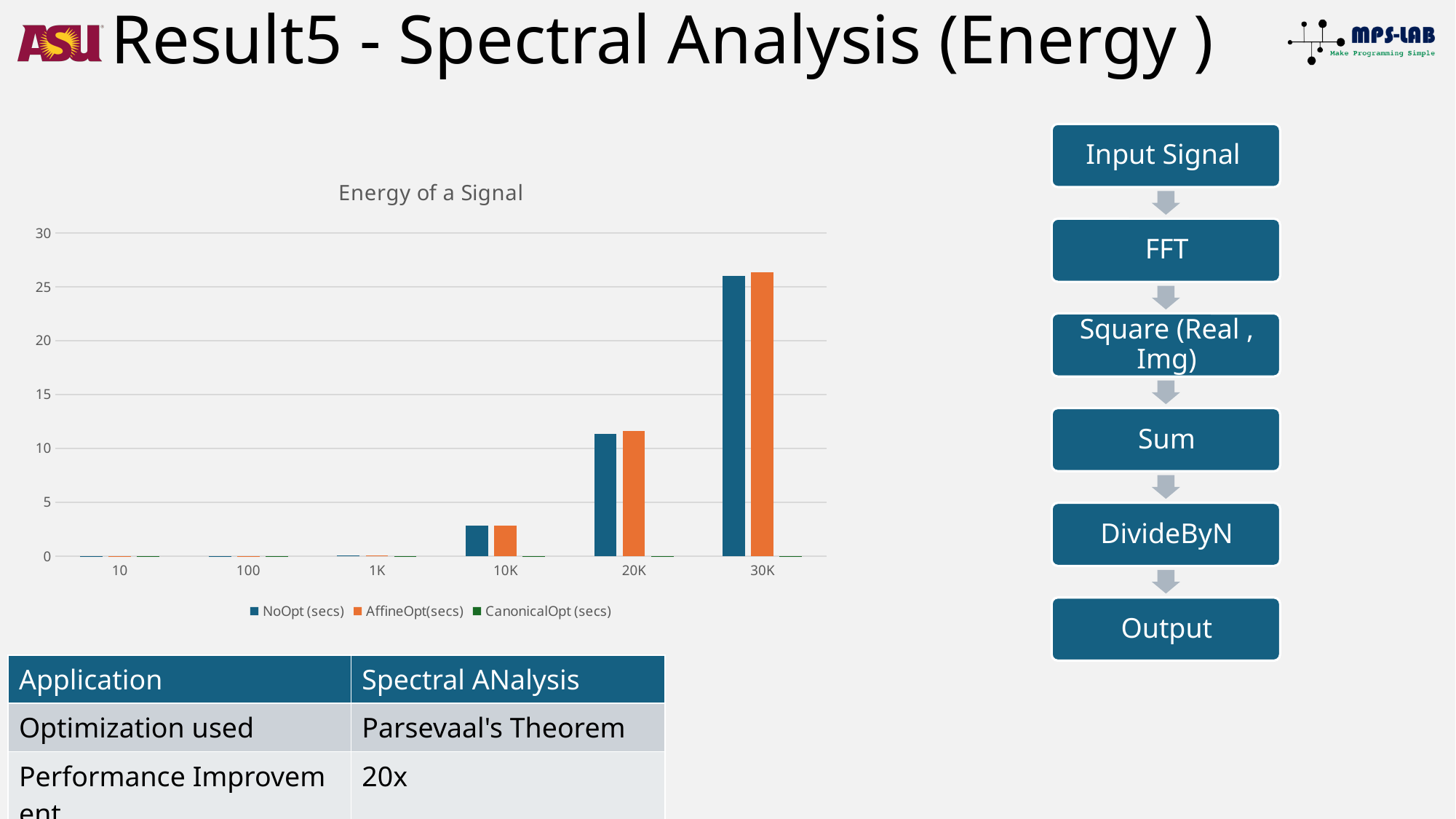
Is the NoOpt (secs) value for 10K greater or less than 5? less What kind of chart is shown on the slide? bar chart Which is larger, the NoOpt (secs) value for 20K or for 30K? 30K Which category has the highest AffineOpt(secs) value? 30K Which series is shown in orange in the chart? AffineOpt(secs) Which category has the highest NoOpt (secs) value? 30K Is the NoOpt (secs) value for 30K greater or less than 25? greater How many categories are shown on the x axis of the chart? 6 How many series does the chart legend list? 3 What is the title of the chart? Energy of a Signal Is the AffineOpt(secs) value for 20K greater or less than 10? greater Do the NoOpt (secs) values rise or fall as the input size increases along the x axis? rise